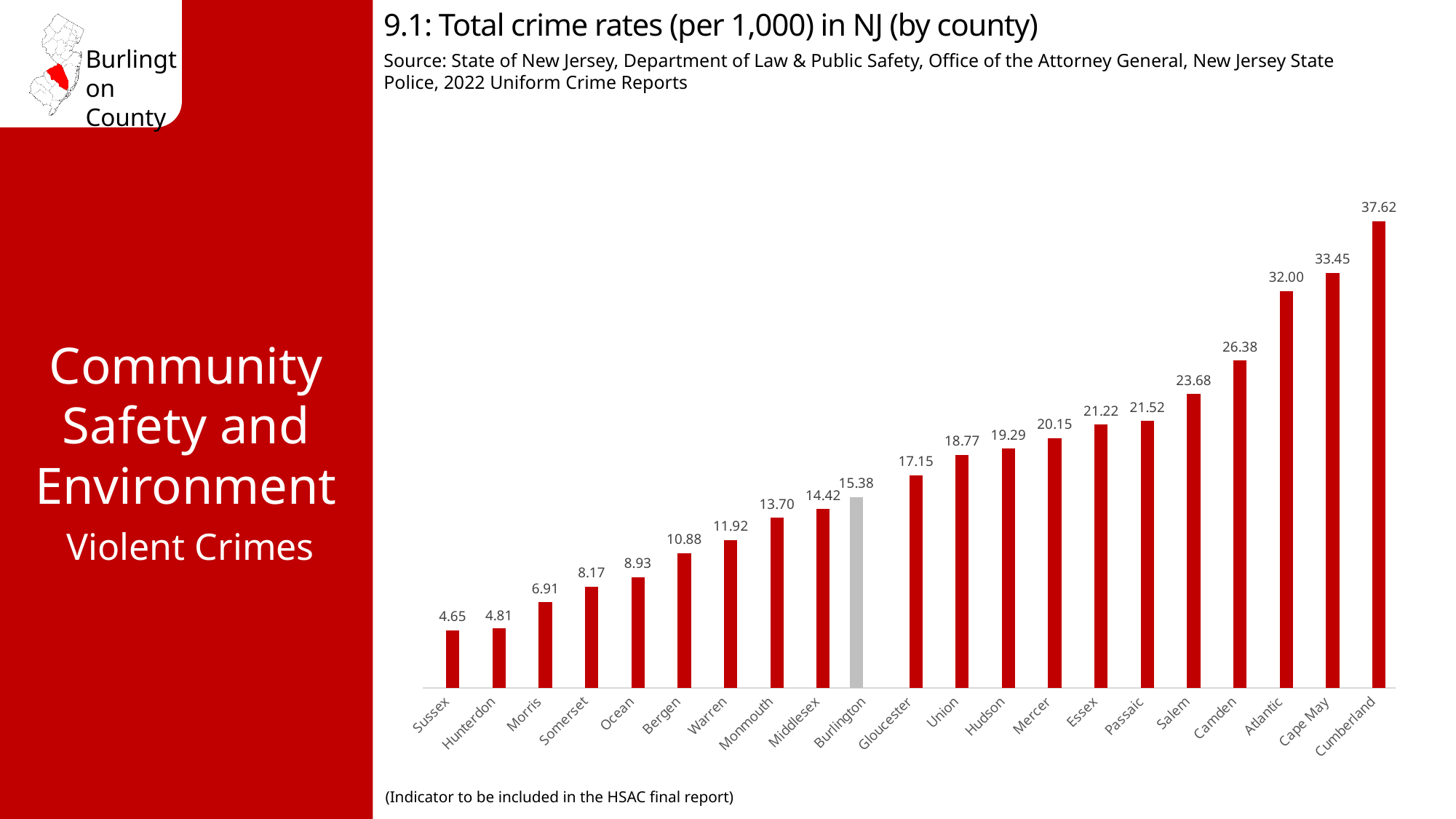
What is the difference between the total crime rates of Cumberland and Sussex? 32.97 What is the total crime rate (per 1,000) for Cape May county? 33.45 What kind of chart is shown on the slide? Bar chart What is the total crime rate (per 1,000) for Hudson county? 19.29 How many counties are shown on the chart? 21 What is the total crime rate (per 1,000) for Burlington county? 15.38 Which county has the lowest total crime rate? Sussex Which county has the highest total crime rate? Cumberland Do the values rise or fall from left to right along the x axis? Rise Which county has a higher total crime rate, Camden or Salem? Camden Which county's bar is coloured grey instead of red? Burlington What is the difference between the total crime rates of Burlington and Gloucester? 1.77